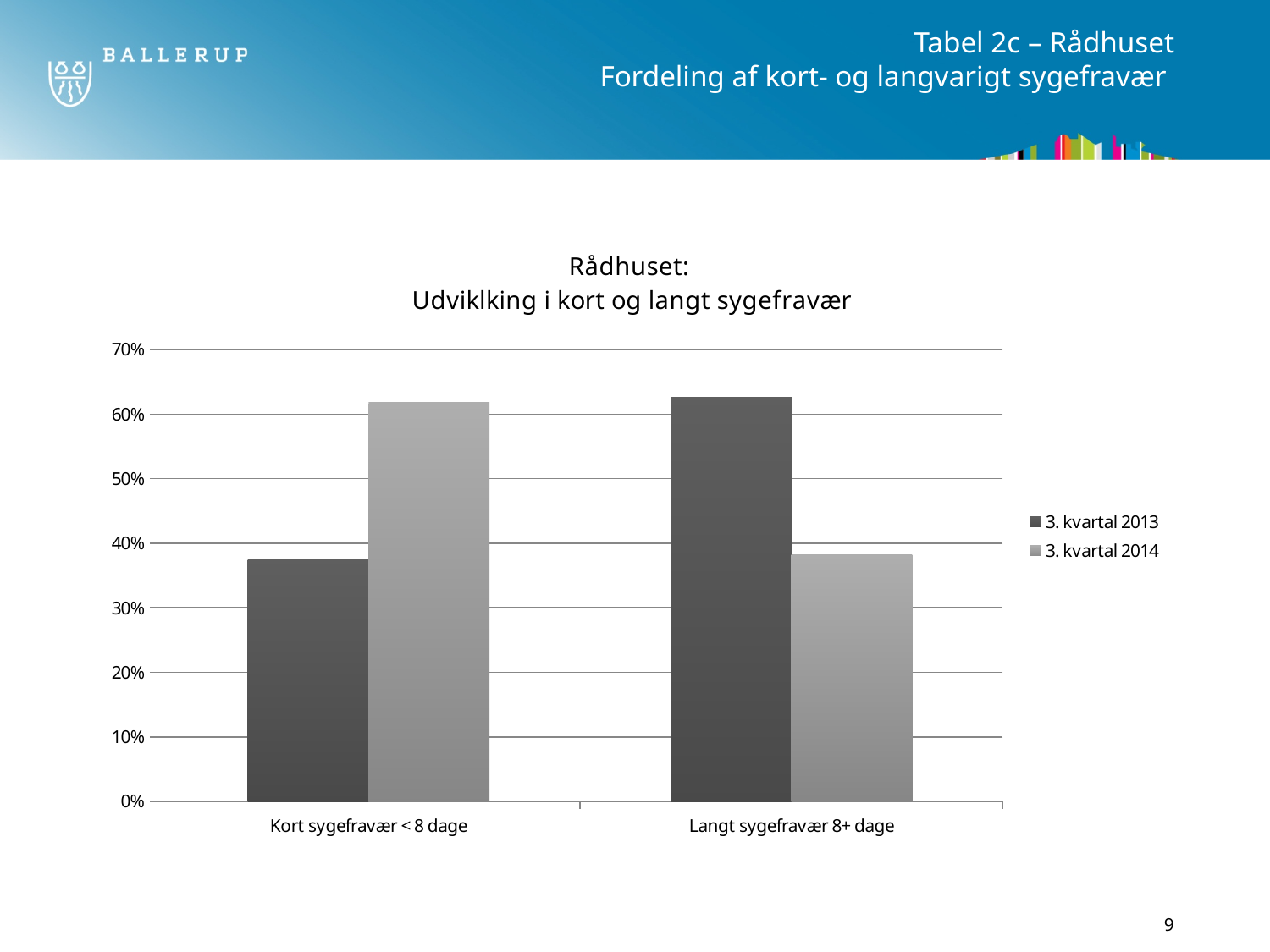
Is the value for Langt sygefravær 8+ dage in 3. kvartal 2014 greater or less than 40%? less For Langt sygefravær 8+ dage, which series has the larger value: 3. kvartal 2013 or 3. kvartal 2014? 3. kvartal 2013 Is the value for Kort sygefravær < 8 dage in 3. kvartal 2013 greater or less than 30%? greater What is the title of the chart? Rådhuset: Udviklking i kort og langt sygefravær What kind of chart is shown on the slide? bar chart Is the value for Kort sygefravær < 8 dage in 3. kvartal 2014 greater or less than 60%? greater How many series does the legend list? 2 For Kort sygefravær < 8 dage, which series has the larger value: 3. kvartal 2013 or 3. kvartal 2014? 3. kvartal 2014 What are the two series listed in the legend? 3. kvartal 2013 and 3. kvartal 2014 How many categories are shown on the x axis of the chart? 2